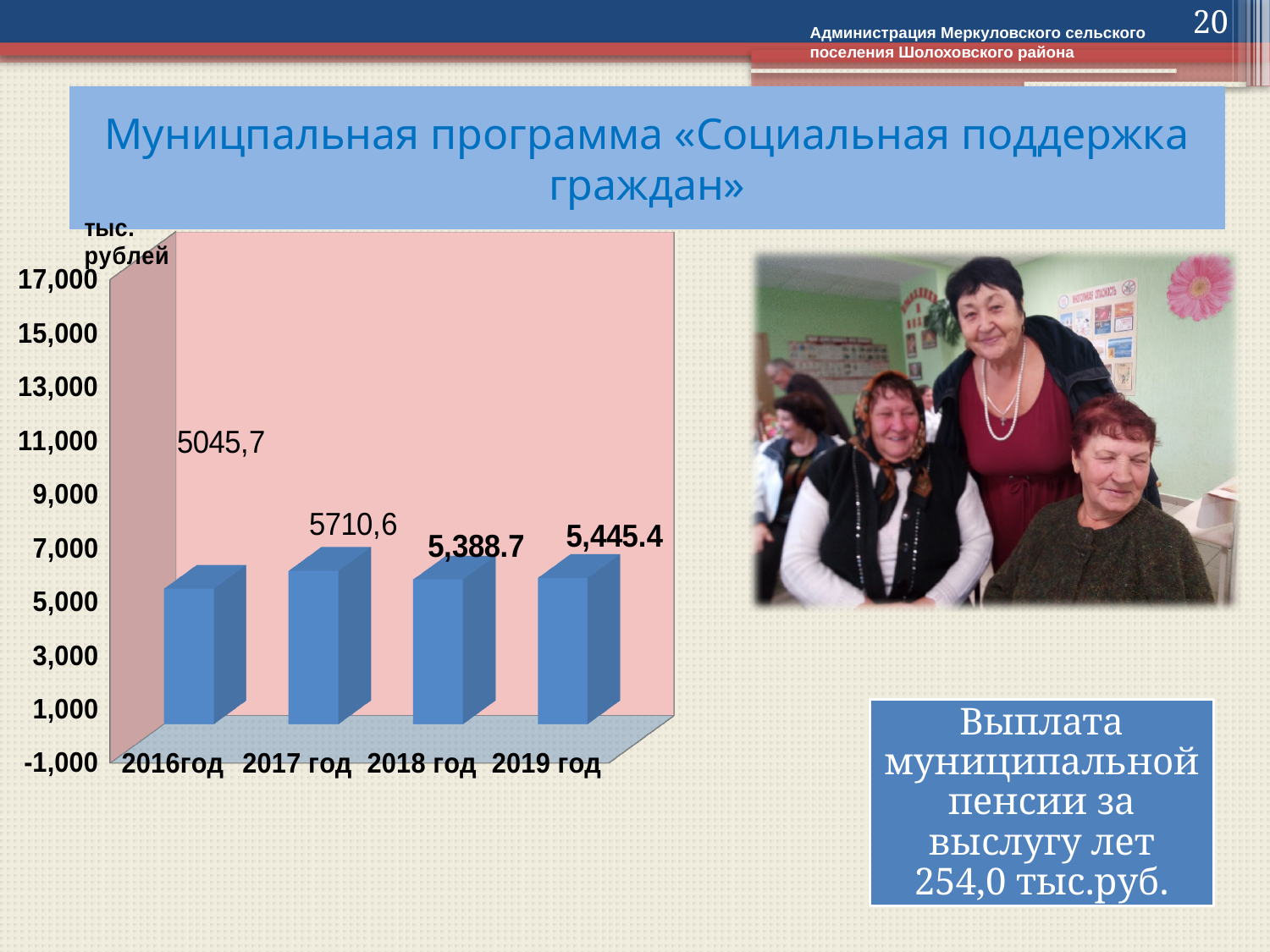
What is the value for 2017 год? 5710,6 Which is larger, the value for 2017 год or the value for 2019 год? 2017 год Is the value for 2017 год greater or less than 7,000? less Which year has the highest value? 2017 год What is the difference between the values for 2019 год and 2018 год? 56.7 What kind of chart is shown on the slide? bar chart Which year has the lowest value? 2016год What unit is shown at the top of the vertical axis? тыс. рублей How many years are shown on the x axis? 4 What is the value for 2019 год? 5,445.4 What is the value for 2016год? 5045,7 What is the value for 2018 год? 5,388.7